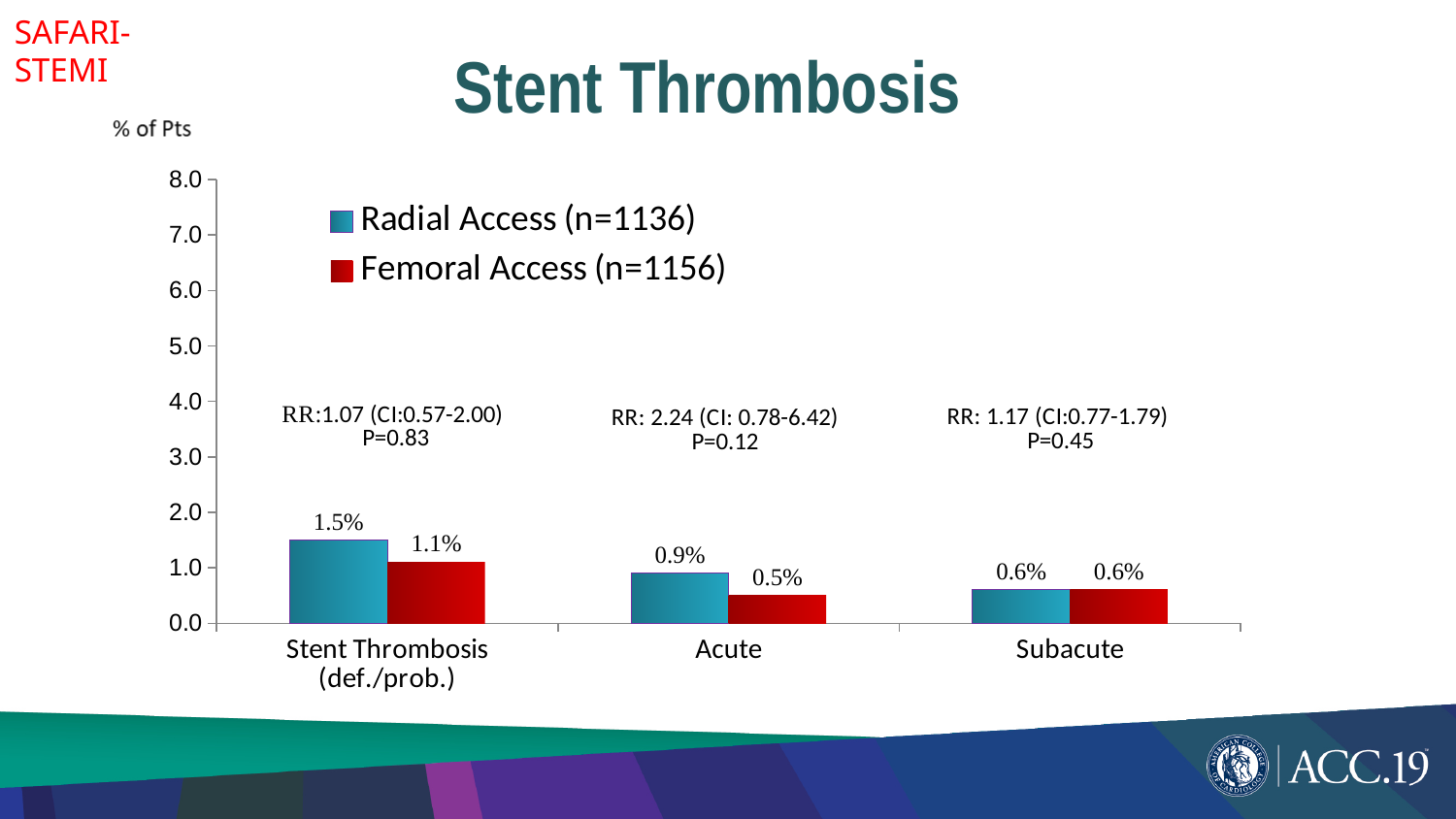
What is the difference between the Radial Access and Femoral Access values in the Stent Thrombosis (def./prob.) category? 0.4% In the Acute category, which series has the larger value, Radial Access or Femoral Access? Radial Access What is the value for Femoral Access in the Subacute category? 0.6% How many series does the legend list? 2 What is the value for Radial Access in the Stent Thrombosis (def./prob.) category? 1.5% What is the value for Femoral Access in the Acute category? 0.5% What is the P value shown for the Acute category? P=0.12 How many categories are shown on the x axis? 3 Which category has the lowest value for Femoral Access? Acute Is the value for Radial Access in the Acute category greater or less than 2.0? less What kind of chart is shown on the slide? Bar chart Which category has the highest value for Radial Access? Stent Thrombosis (def./prob.)